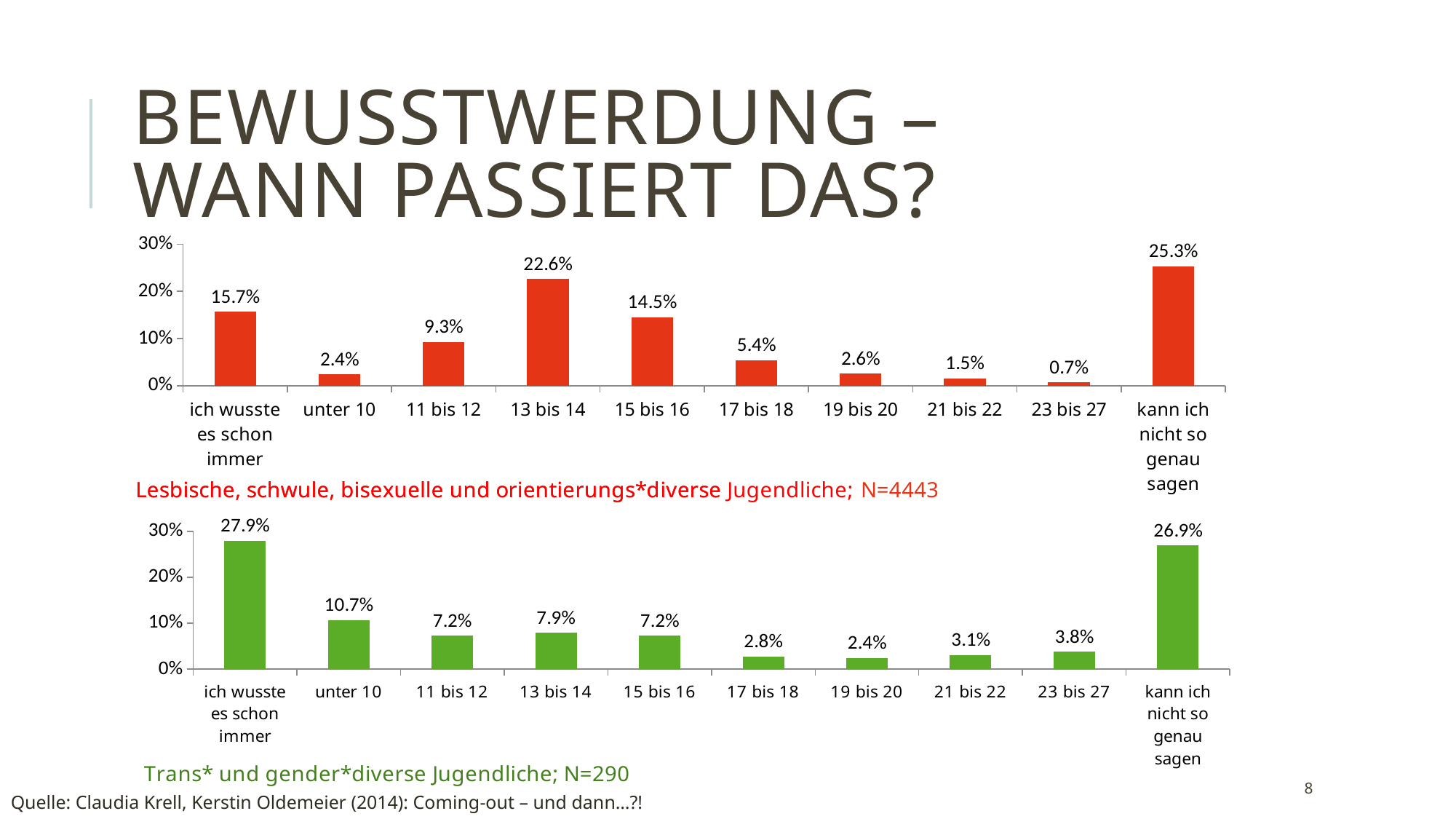
In the top (red) chart, what is the difference between the values for '13 bis 14' and '15 bis 16'? 8.1% In the bottom (green) chart for Trans* und gender*diverse Jugendliche, what is the value for 'unter 10'? 10.7% In the top (red) chart, which category has the highest value? kann ich nicht so genau sagen In the bottom (green) chart, which category has the highest value? ich wusste es schon immer In the top (red) chart for lesbische, schwule, bisexuelle und orientierungs*diverse Jugendliche, what is the value for '13 bis 14'? 22.6% In the top (red) chart, which category has the lowest value? 23 bis 27 How many categories are shown on the x axis of the bottom (green) chart? 10 In the bottom (green) chart, what is the difference between 'ich wusste es schon immer' and 'kann ich nicht so genau sagen'? 1.0% In the bottom (green) chart, which category has the lowest value? 19 bis 20 What kind of chart is the top (red) chart? Bar chart In the top (red) chart, which is larger: the value for '11 bis 12' or the value for '17 bis 18'? 11 bis 12 What is the N (sample size) given for the bottom (green) chart on Trans* und gender*diverse Jugendliche? N=290